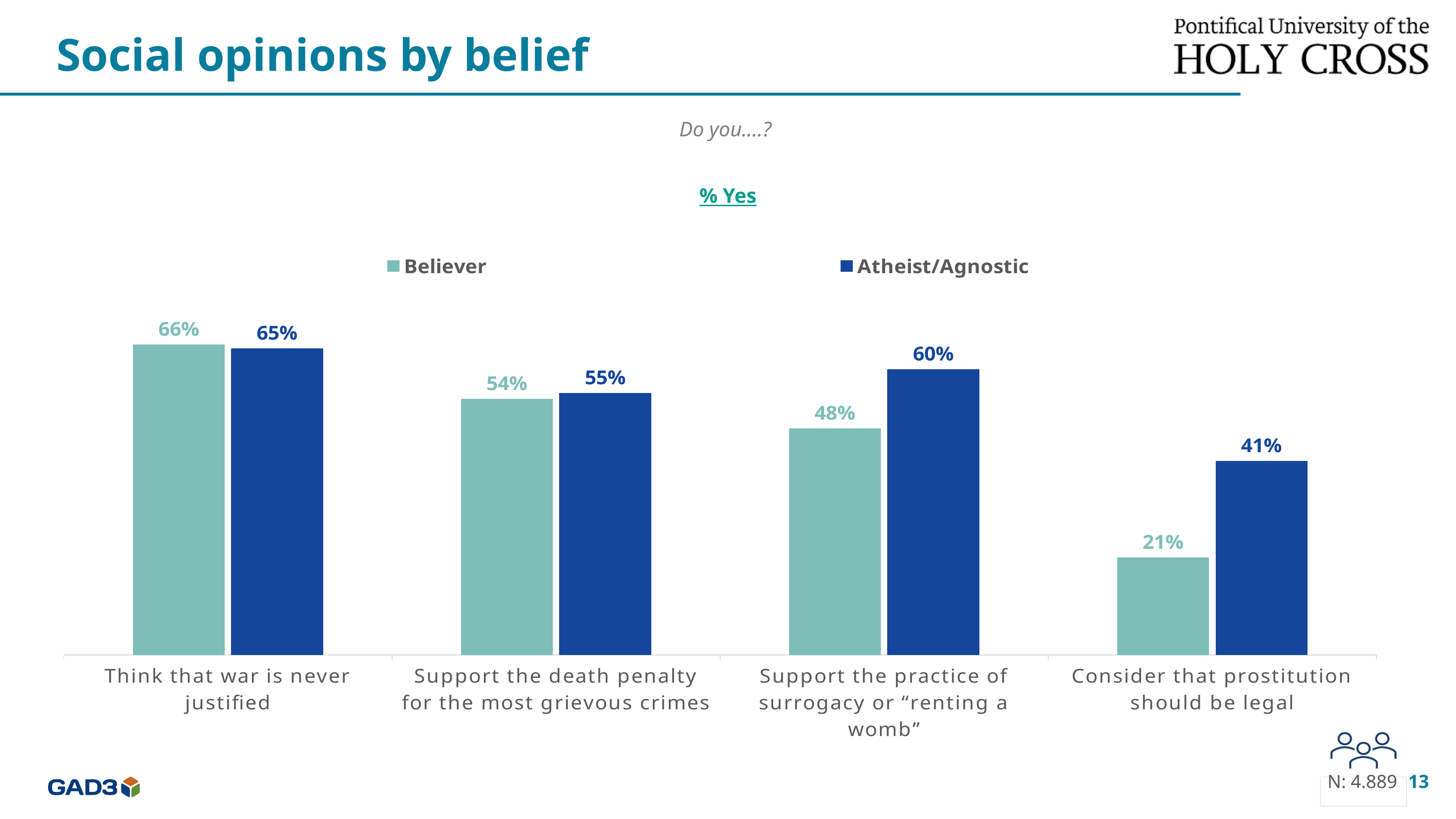
What percentage of Believers consider that prostitution should be legal? 21% How many series does the legend list? 2 What is the difference between the Atheist/Agnostic and Believer values for considering that prostitution should be legal? 20% How many categories are shown on the x axis of the chart? 4 What percentage of Believers think that war is never justified? 66% For supporting the practice of surrogacy, which group has the larger value, Believer or Atheist/Agnostic? Atheist/Agnostic Which category has the highest value for the Atheist/Agnostic series? Think that war is never justified What percentage of Atheist/Agnostic respondents support the death penalty for the most grievous crimes? 55% Which category has the lowest value for the Believer series? Consider that prostitution should be legal What is the difference between the Atheist/Agnostic and Believer values for supporting the practice of surrogacy? 12% What kind of chart is shown on the slide? Bar chart What percentage of Atheist/Agnostic respondents support the practice of surrogacy or "renting a womb"? 60%